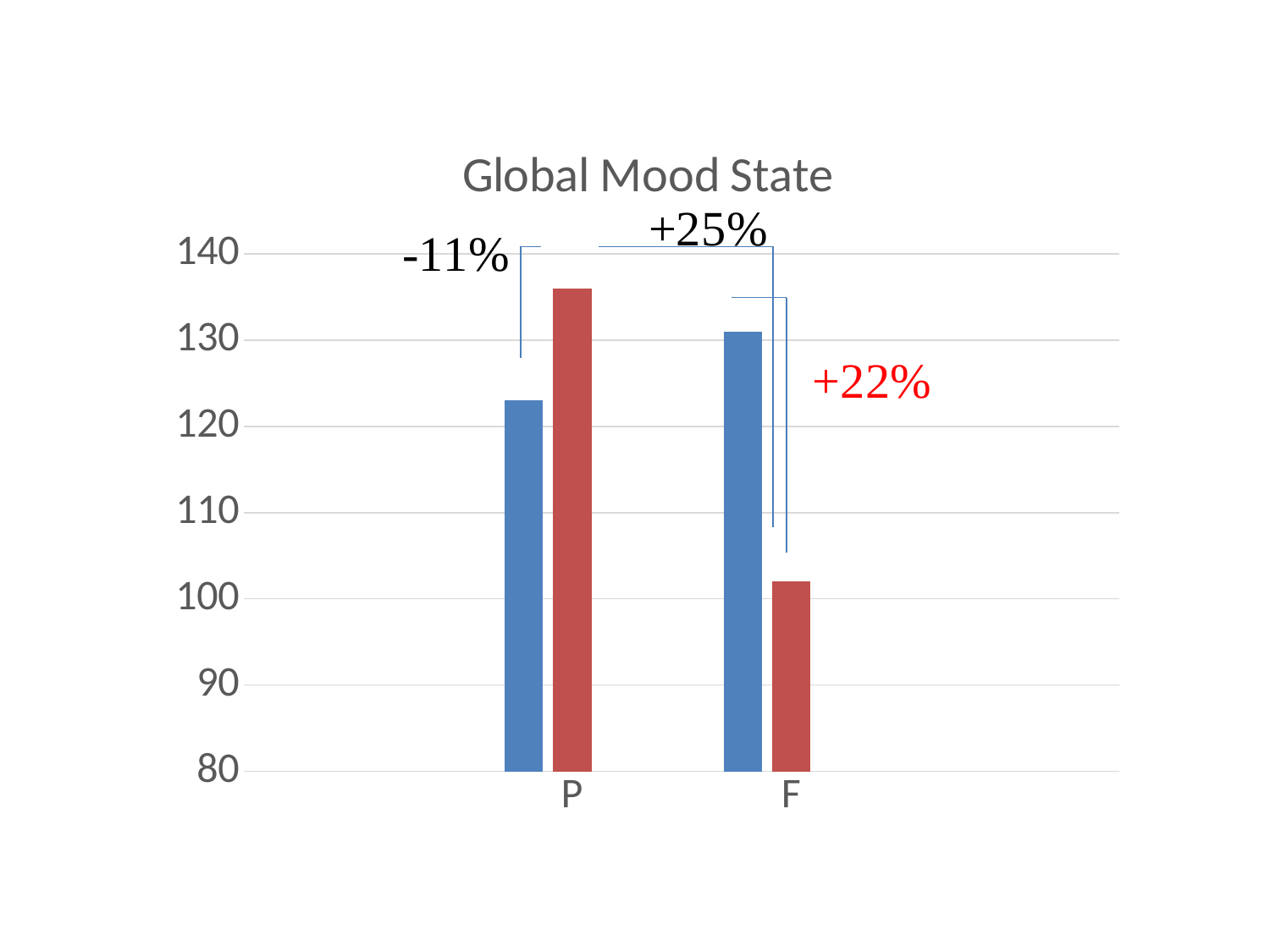
What percentage change is written in red on the chart? +22% What is the title of the chart? Global Mood State Is the red bar for P greater or less than 130? greater Is the blue bar for F greater or less than 120? greater Is the blue bar for P greater or less than 120? greater Which bar is the shortest in the chart? the red bar for F Which bar is the tallest in the chart? the red bar for P For category F, which bar is taller, the blue bar or the red bar? the blue bar How many categories are shown on the x axis of the chart? 2 What kind of chart is shown on the slide? bar chart For category P, which bar is taller, the blue bar or the red bar? the red bar